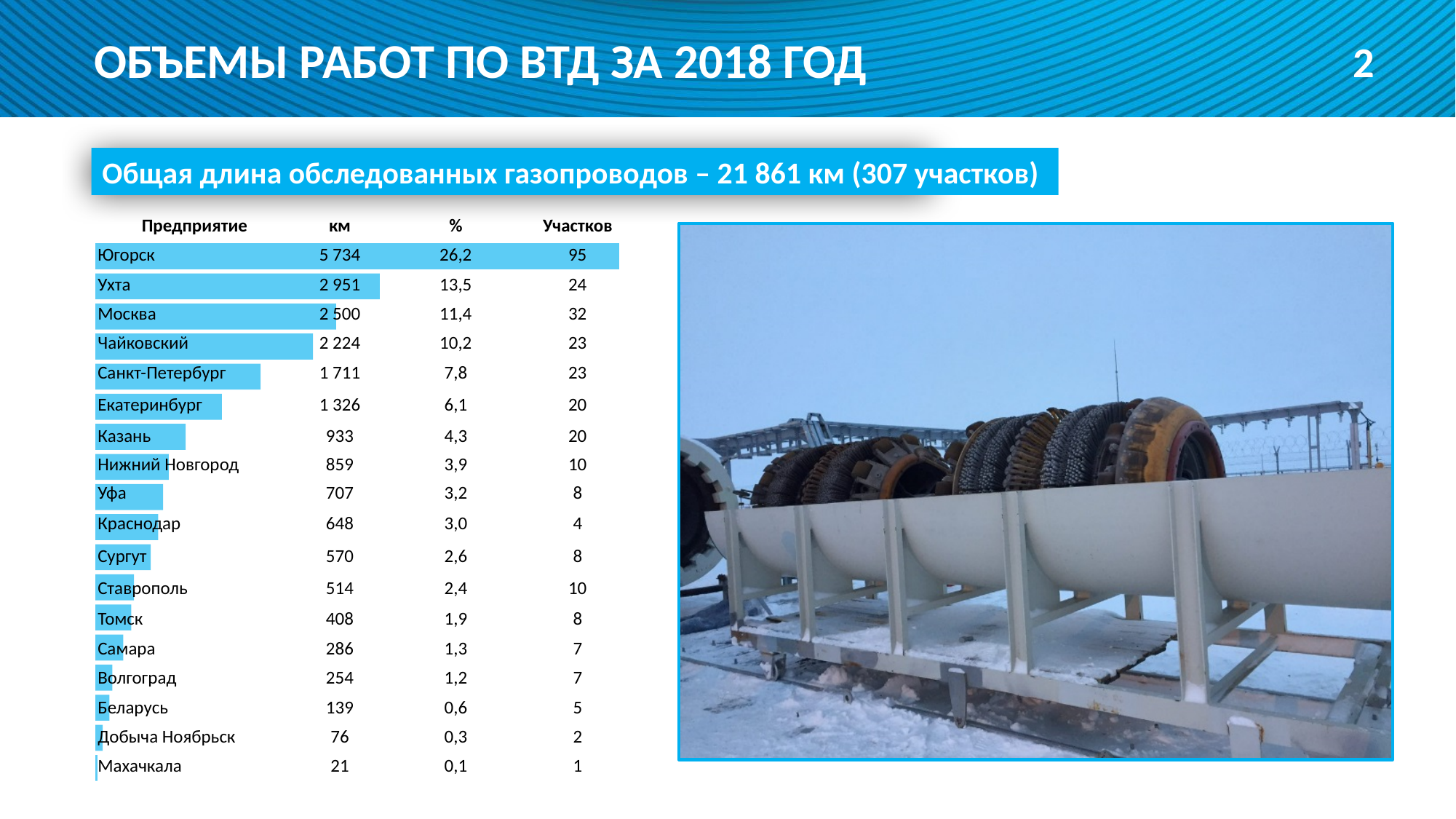
Which enterprise has the lowest value in km? Махачкала What is the km value for Ухта? 2 951 What kind of chart is shown behind the table of enterprises on the slide? bar chart Which enterprise has the highest value in km? Югорск What is the km value for Добыча Ноябрьск? 76 Which has a larger km value, Казань or Нижний Новгород? Казань What total length of surveyed gas pipelines is stated in the heading above the chart? 21 861 км What is the difference in km between Югорск and Ухта? 2 783 What percentage share is shown for Москва? 11,4 How many участков are shown for Санкт-Петербург? 23 Do the km values rise or fall going down the list from Югорск to Махачкала? fall How many enterprises (categories) are listed in the chart? 18